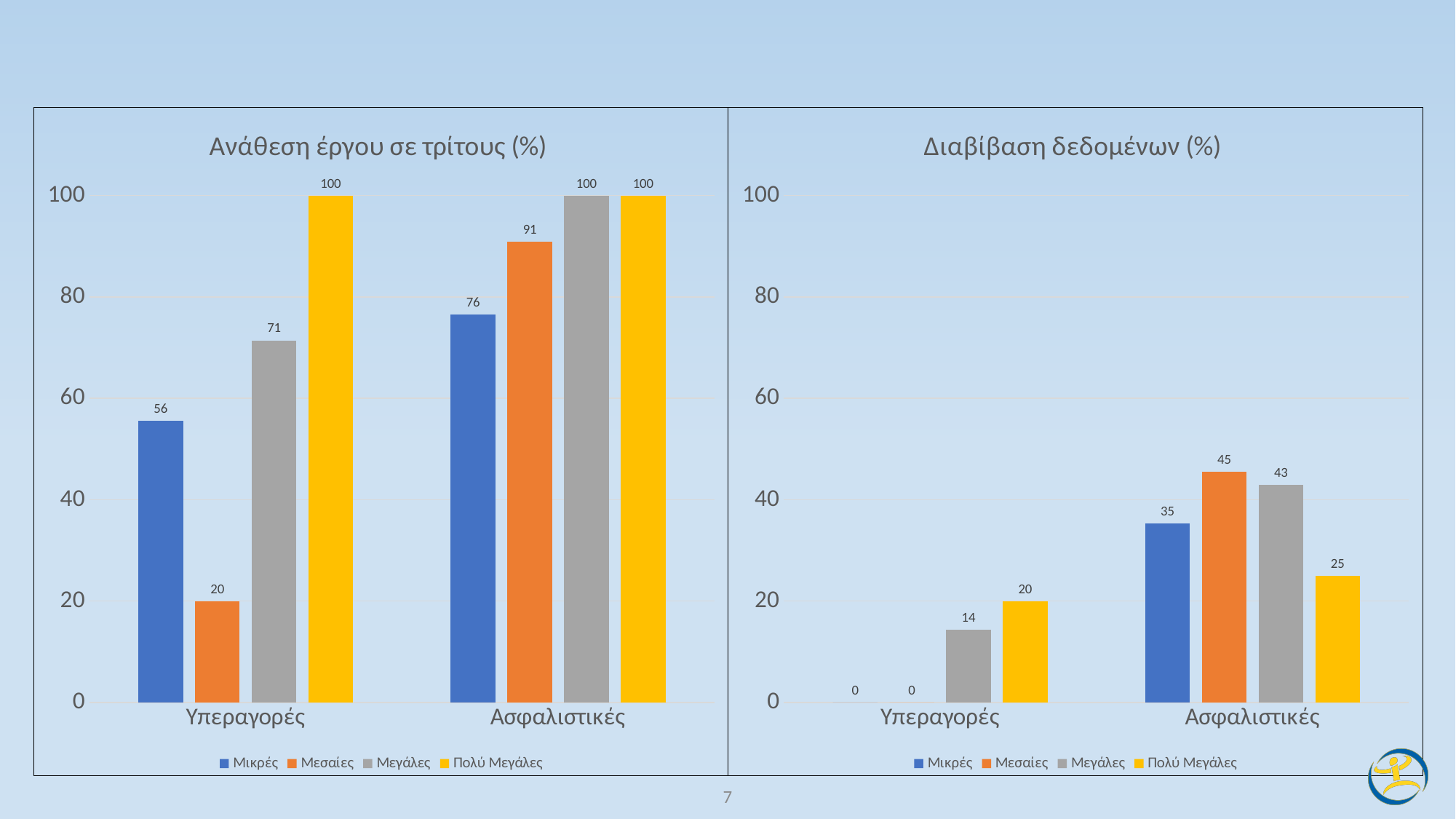
In the chart titled 'Διαβίβαση δεδομένων (%)', which series has the highest value in the Ασφαλιστικές category? Μεσαίες What kind of chart is the chart titled 'Διαβίβαση δεδομένων (%)'? Bar chart In the chart titled 'Διαβίβαση δεδομένων (%)', what is the difference between the Μικρές value for Ασφαλιστικές and the Πολύ Μεγάλες value for Υπεραγορές? 15 In the chart titled 'Ανάθεση έργου σε τρίτους (%)', what is the value for Μεσαίες in the Ασφαλιστικές category? 91 In the chart titled 'Διαβίβαση δεδομένων (%)', what is the value for Πολύ Μεγάλες in the Ασφαλιστικές category? 25 In the chart titled 'Διαβίβαση δεδομένων (%)', which is larger: the Μεσαίες value for Ασφαλιστικές or the Πολύ Μεγάλες value for Ασφαλιστικές? Μεσαίες In the chart titled 'Ανάθεση έργου σε τρίτους (%)', what is the difference between the Μεγάλες values for Ασφαλιστικές and Υπεραγορές? 29 In the chart titled 'Διαβίβαση δεδομένων (%)', which colour represents the Μεγάλες series? Grey In the chart titled 'Ανάθεση έργου σε τρίτους (%)', which series has the lowest value in the Υπεραγορές category? Μεσαίες In the chart titled 'Ανάθεση έργου σε τρίτους (%)', what is the value for Μικρές in the Υπεραγορές category? 56 In the chart titled 'Διαβίβαση δεδομένων (%)', what is the value for Μεγάλες in the Υπεραγορές category? 14 How many series does the legend of the chart titled 'Ανάθεση έργου σε τρίτους (%)' list? 4